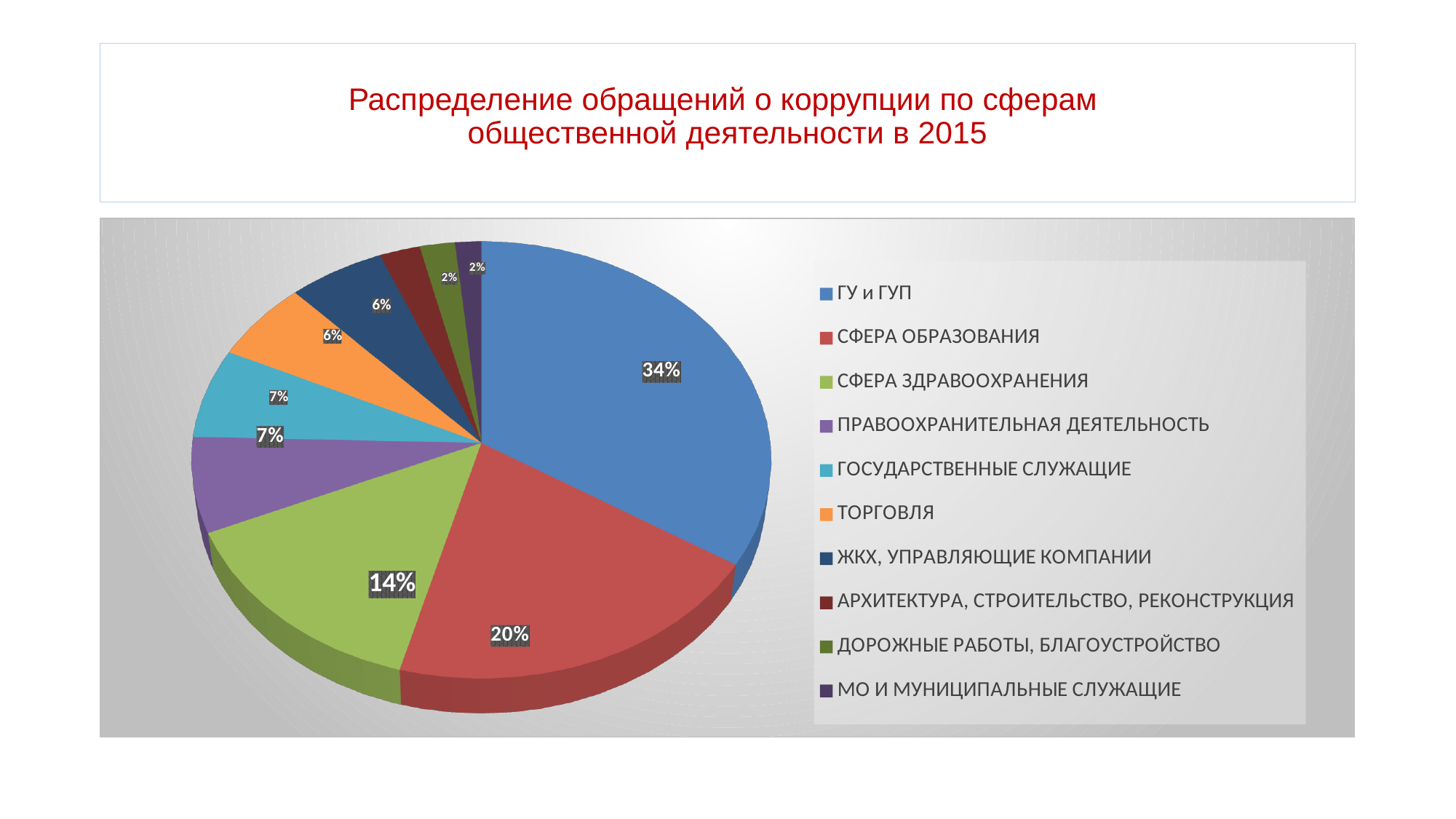
What type of chart is shown on the slide? Pie chart What percentage is shown for СФЕРА ЗДРАВООХРАНЕНИЯ? 14% What percentage is shown for ГОСУДАРСТВЕННЫЕ СЛУЖАЩИЕ? 7% What share of the pie does ГУ и ГУП have? 34% Which category has the largest share of the pie? ГУ и ГУП Which has a larger share: СФЕРА ЗДРАВООХРАНЕНИЯ or ПРАВООХРАНИТЕЛЬНАЯ ДЕЯТЕЛЬНОСТЬ? СФЕРА ЗДРАВООХРАНЕНИЯ What is the title of the slide? Распределение обращений о коррупции по сферам общественной деятельности в 2015 What percentage is shown for СФЕРА ОБРАЗОВАНИЯ? 20% What is the difference in percentage points between ГУ и ГУП and СФЕРА ОБРАЗОВАНИЯ? 14 What percentage is shown for ТОРГОВЛЯ? 6% How many categories does the legend list? 10 What colour is the slice for СФЕРА ОБРАЗОВАНИЯ? Red